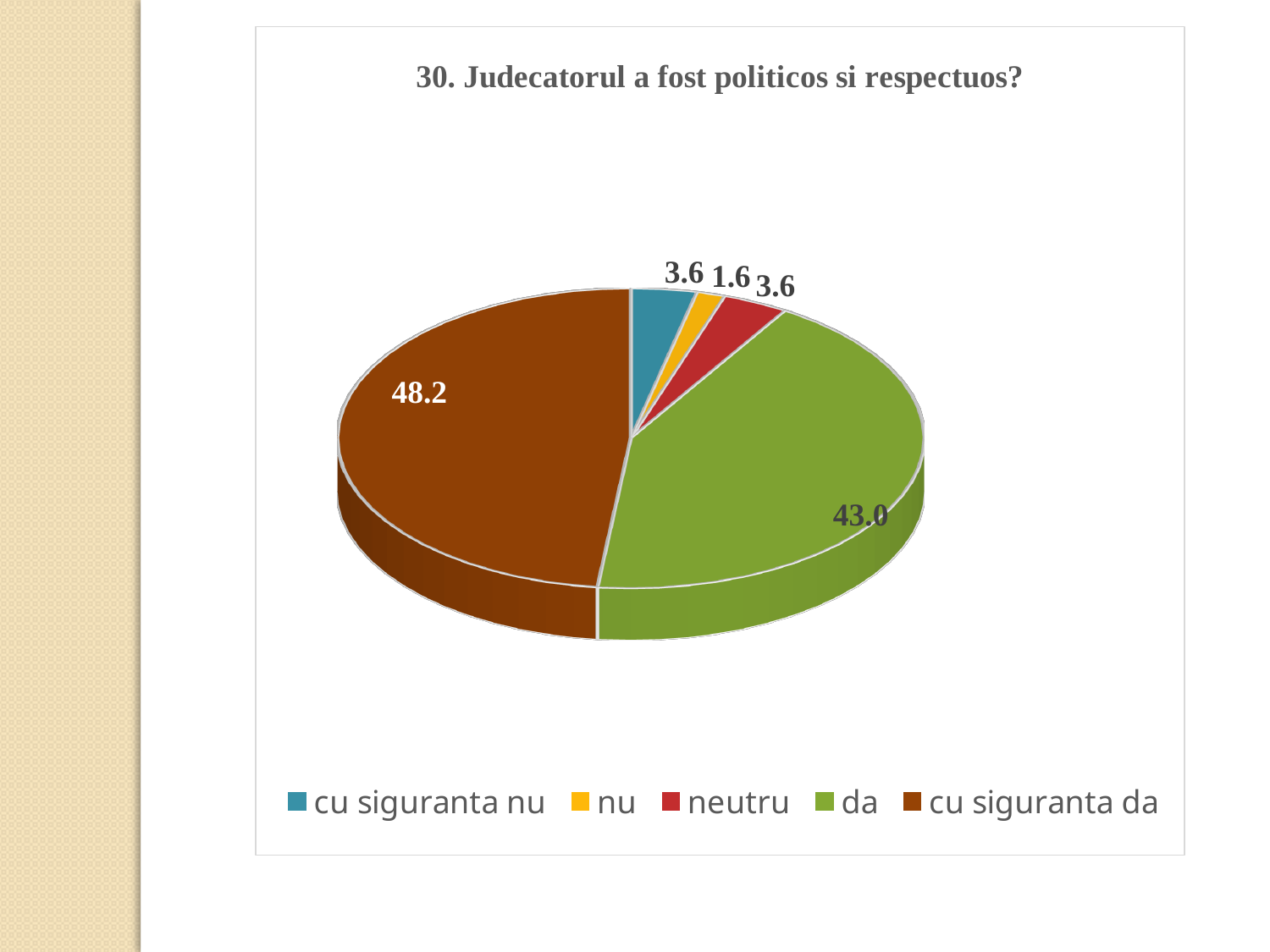
How many categories does the legend list? 5 What is the value for "neutru"? 3.6 What is the difference between the values for "cu siguranta da" and "da"? 5.2 What is the title of the chart? 30. Judecatorul a fost politicos si respectuos? Which category has the smallest slice of the pie? nu What is the value for "da"? 43.0 What is the value for "cu siguranta da"? 48.2 Which category has the largest slice of the pie? cu siguranta da What is the value for "nu"? 1.6 What colour is the slice for "da"? green Which is larger, the value for "da" or the value for "cu siguranta da"? cu siguranta da What kind of chart is shown on the slide? pie chart